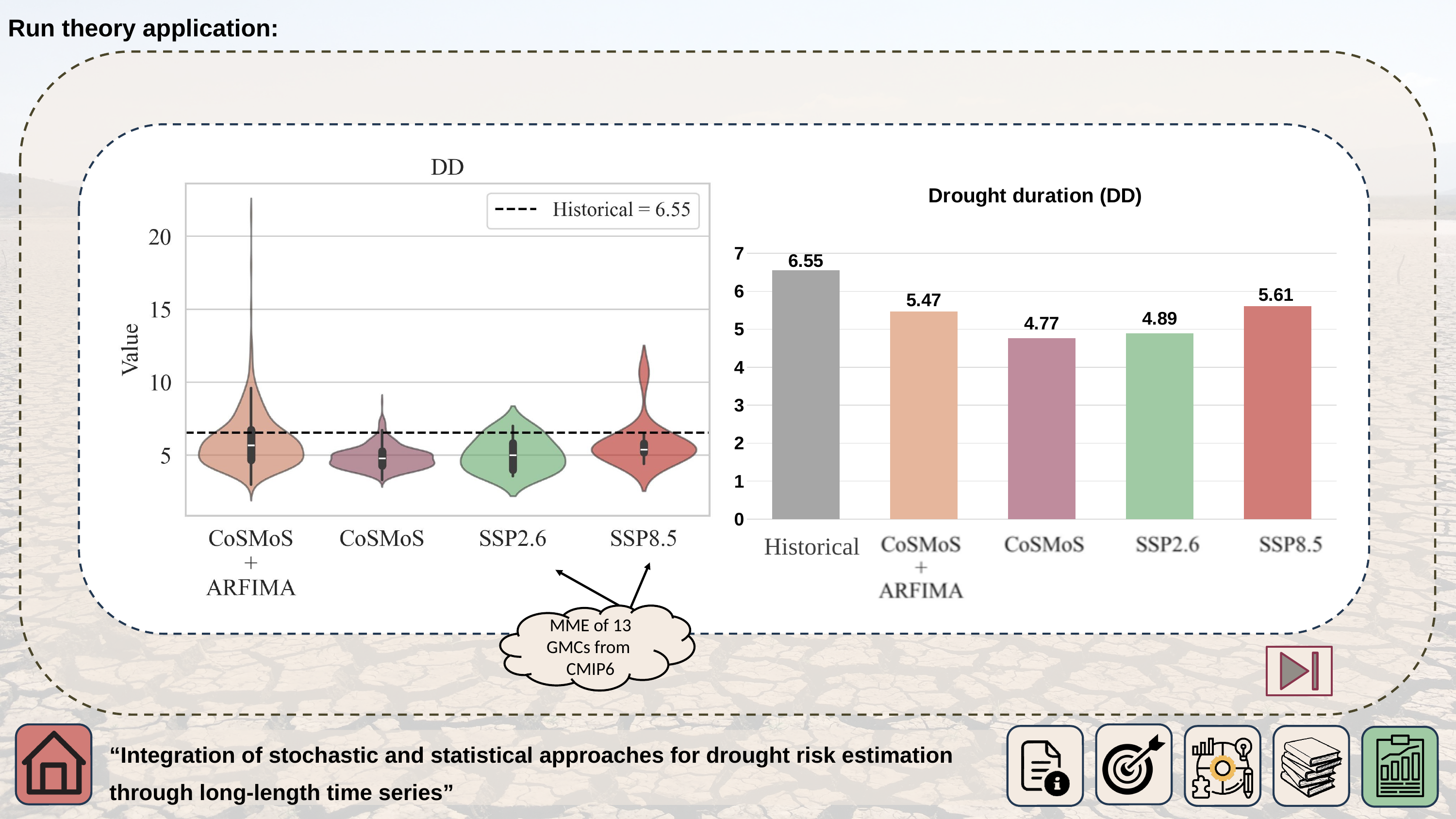
In the 'DD' chart on the left of the slide, what Historical value does the dashed line in the legend represent? 6.55 In the 'Drought duration (DD)' bar chart, which category has the lowest value? CoSMoS What is the title of the chart on the left of the slide? DD In the 'Drought duration (DD)' bar chart, is the value for CoSMoS greater or less than 5? less What kind of chart is the chart on the right of the slide titled 'Drought duration (DD)'? bar chart In the 'Drought duration (DD)' bar chart, which category has the highest value? Historical In the 'Drought duration (DD)' bar chart, what is the value for CoSMoS + ARFIMA? 5.47 In the 'Drought duration (DD)' bar chart, which is larger, the value for SSP2.6 or the value for SSP8.5? SSP8.5 In the 'Drought duration (DD)' bar chart, what is the value for Historical? 6.55 In the 'Drought duration (DD)' bar chart, what is the value for SSP8.5? 5.61 In the 'Drought duration (DD)' bar chart, what is the difference between the Historical value and the CoSMoS value? 1.78 How many bars are shown in the 'Drought duration (DD)' bar chart? 5